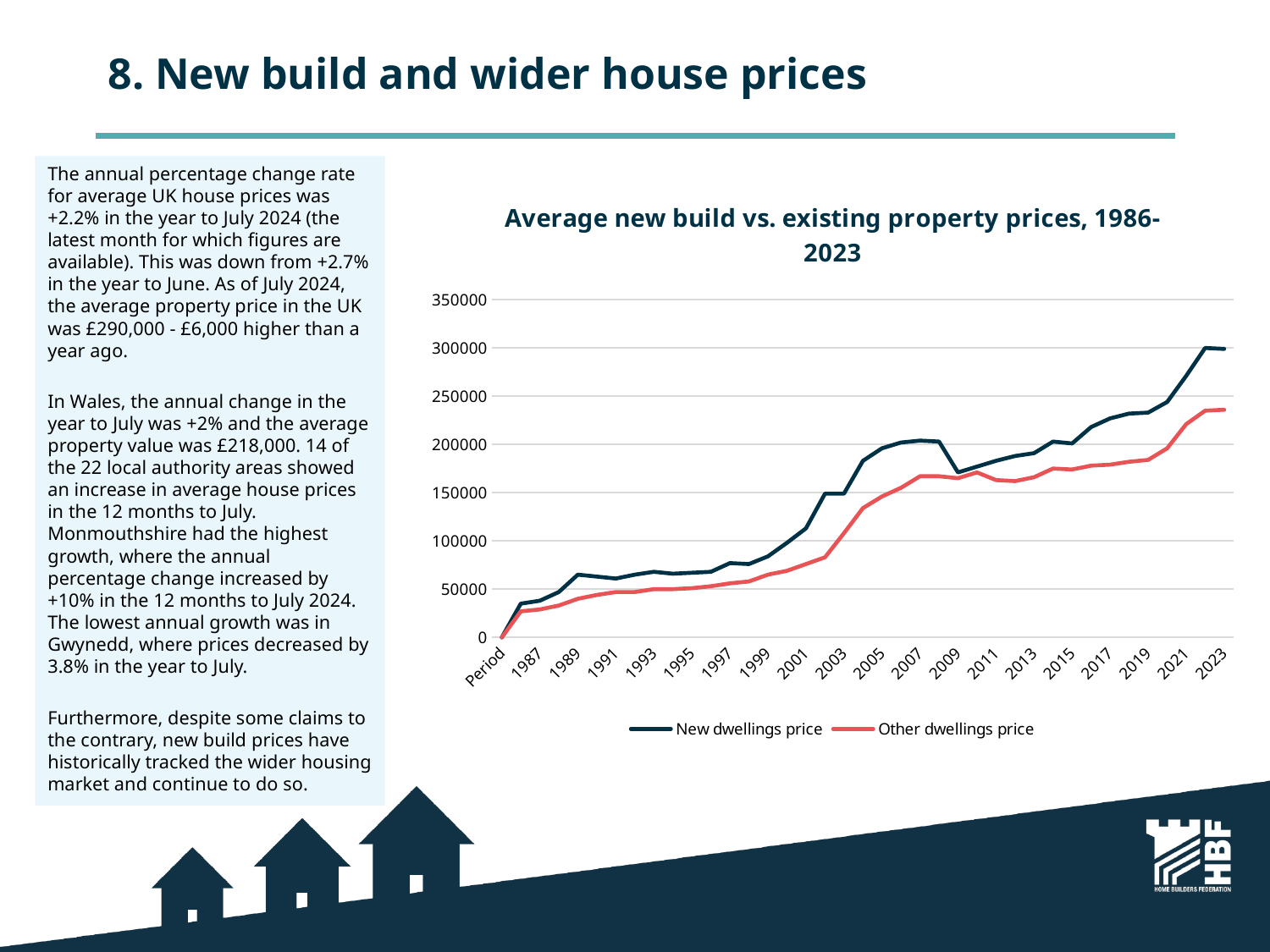
In 2023, which series has the higher value, New dwellings price or Other dwellings price? New dwellings price Is the Other dwellings price in 2023 greater or less than 250000? less Which series is drawn in red? Other dwellings price Overall, do the New dwellings price values rise or fall from 1987 to 2023? rise What kind of chart is shown on the slide? line chart Is the New dwellings price in 2005 greater or less than 150000? greater Is the New dwellings price in 2023 greater or less than 250000? greater What is the title of the chart? Average new build vs. existing property prices, 1986-2023 How many series does the legend list? 2 In 2003, which series has the lower value, New dwellings price or Other dwellings price? Other dwellings price